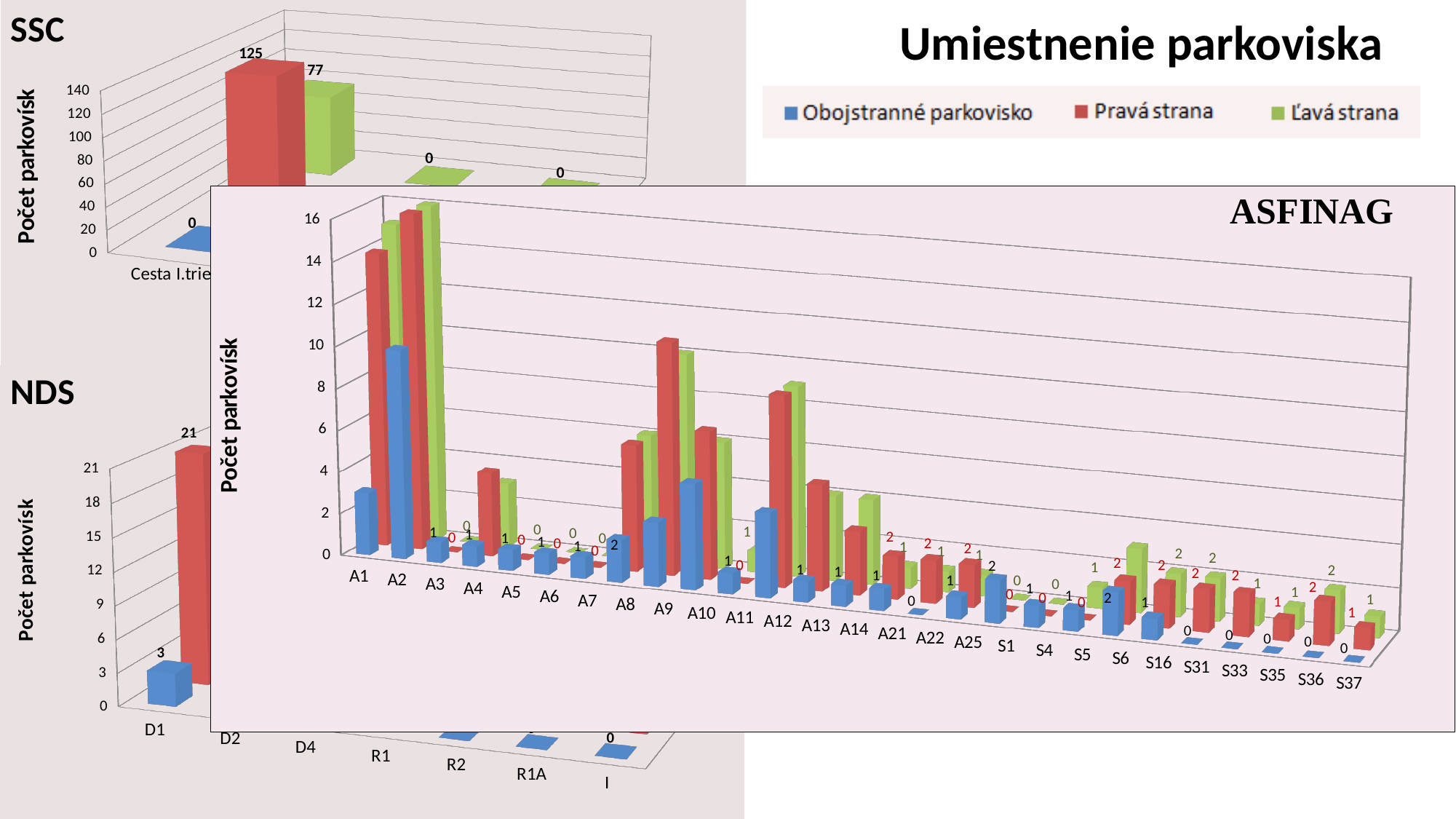
In the ASFINAG chart, how many categories are shown on the x axis? 27 How many series does the legend list? 3 In the NDS chart, what is the value for Obojstranné parkovisko at D1? 3 In the SSC chart, what is the value for Pravá strana at Cesta I.triedy? 125 In the NDS chart, what is the value for Pravá strana at D1? 21 In the SSC chart, what is the value for Ľavá strana at Cesta I.triedy? 77 In the ASFINAG chart, which is larger at A1: Pravá strana or Ľavá strana? Ľavá strana In the ASFINAG chart, is the value for Pravá strana at A9 greater or less than 8? greater In the SSC chart, what is the difference between the Pravá strana and Ľavá strana values at Cesta I.triedy? 48 In the NDS chart, how much larger is the Pravá strana value than the Obojstranné parkovisko value at D1? 18 What kind of chart is the ASFINAG chart? bar chart Which colour represents Pravá strana in the legend? red